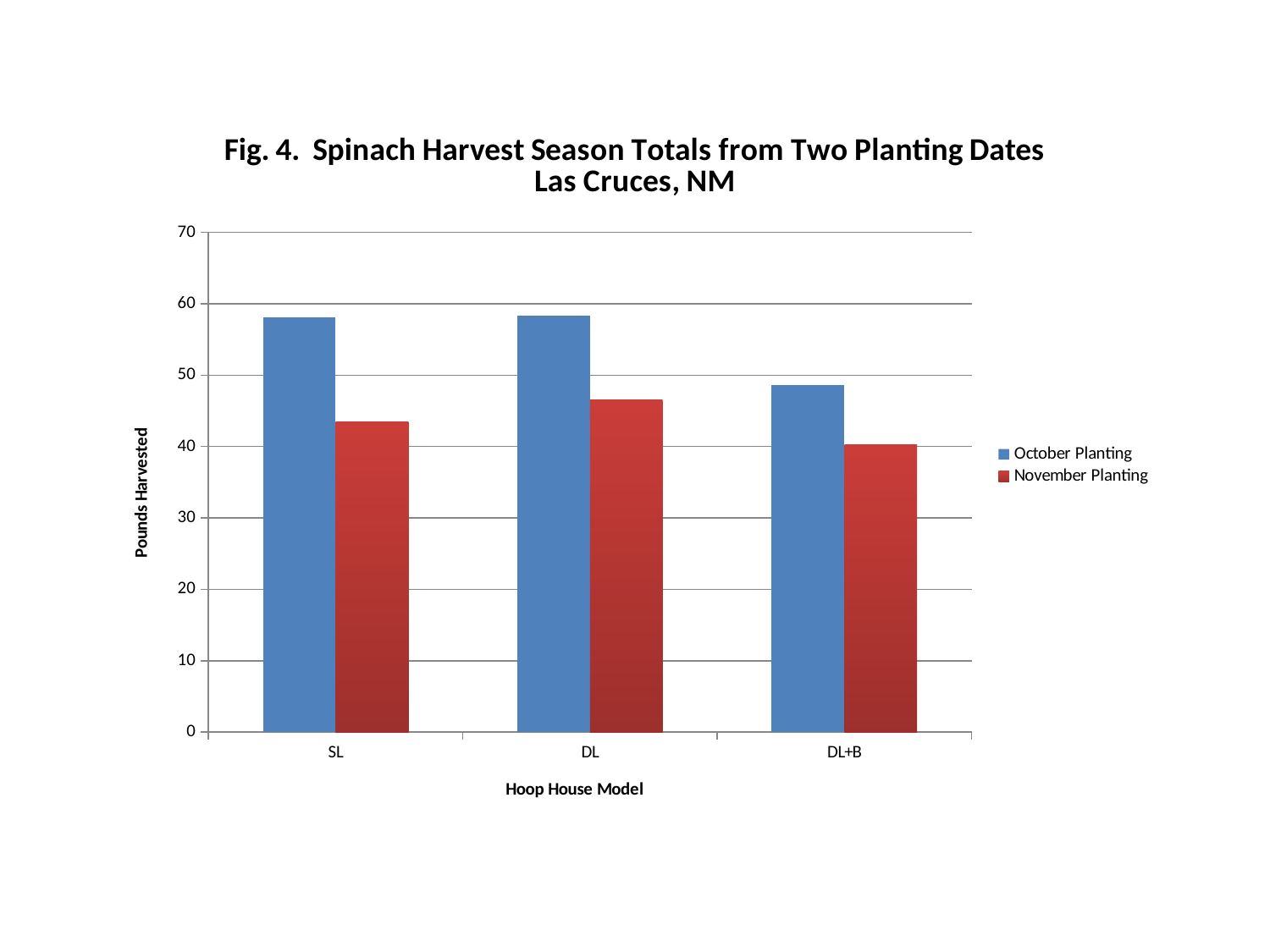
What is the label of the y axis? Pounds Harvested Is the November Planting value for DL greater or less than 50? less Which hoop house model has the lowest October Planting harvest? DL+B How many hoop house models are shown on the x axis? 3 For the SL model, which is larger: the October Planting or the November Planting harvest? October Planting What kind of chart is shown on the slide? bar chart Which colour represents November Planting in the legend? red Is the October Planting value for SL greater or less than 50? greater Which hoop house model has the highest November Planting harvest? DL Is the October Planting value for DL+B greater or less than 50? less Which hoop house model has the lowest November Planting harvest? DL+B How many series does the legend list? 2